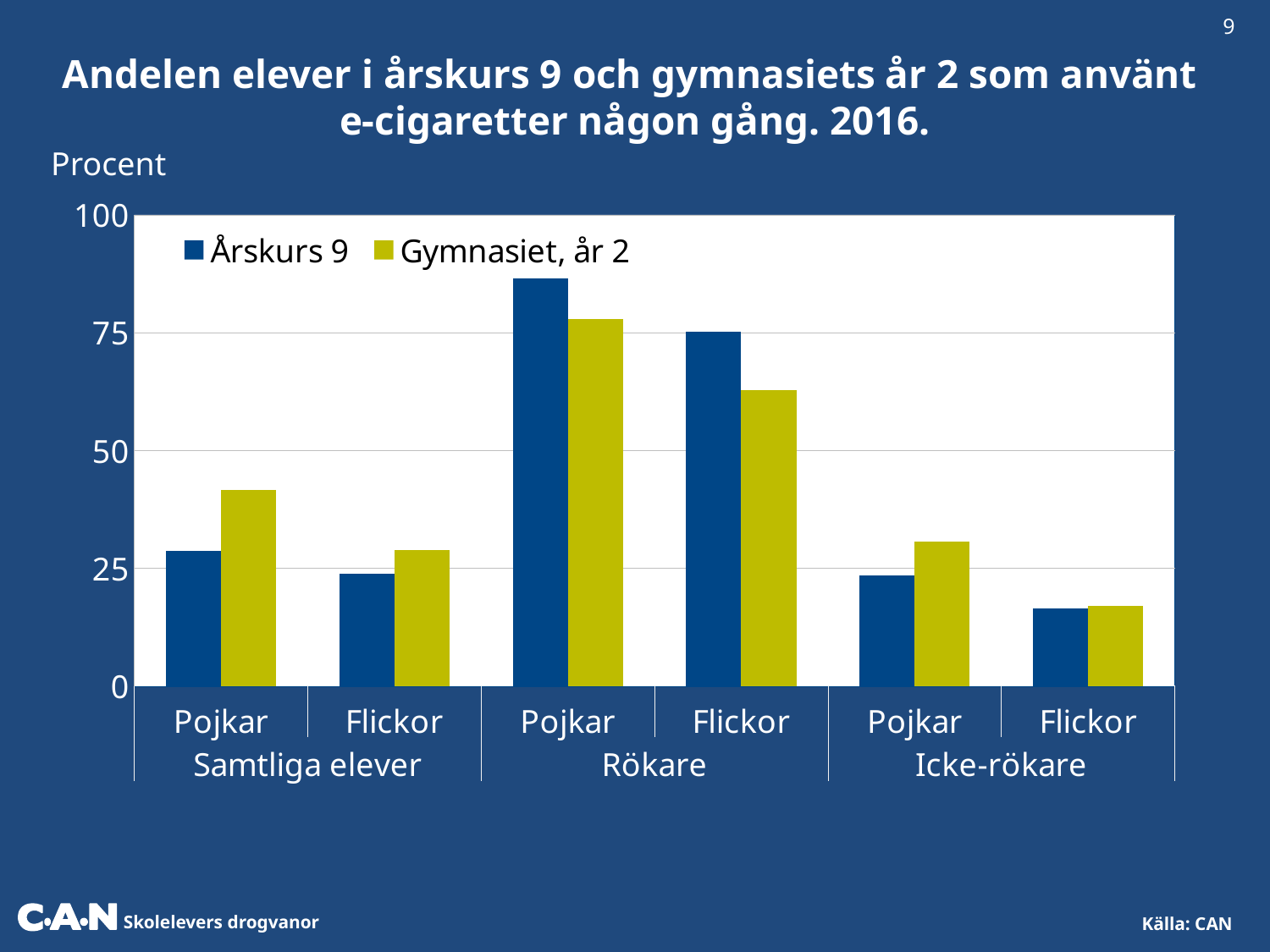
What unit is shown on the y axis label? Procent Is the value for Pojkar among Samtliga elever in Gymnasiet, år 2 greater or less than 50? less Is the value for Flickor among Rökare in Gymnasiet, år 2 greater or less than 50? greater What kind of chart is shown on the slide? bar chart How many series does the legend list? 2 Among Rökare, which is larger for Flickor: Årskurs 9 or Gymnasiet, år 2? Årskurs 9 Is the value for Flickor among Icke-rökare in Årskurs 9 greater or less than 25? less How many main groups are shown along the x axis? 3 What are the two series named in the legend? Årskurs 9 and Gymnasiet, år 2 Among Samtliga elever, which is larger for Pojkar: Årskurs 9 or Gymnasiet, år 2? Gymnasiet, år 2 Which bar is the highest in the chart? Pojkar, Rökare, Årskurs 9